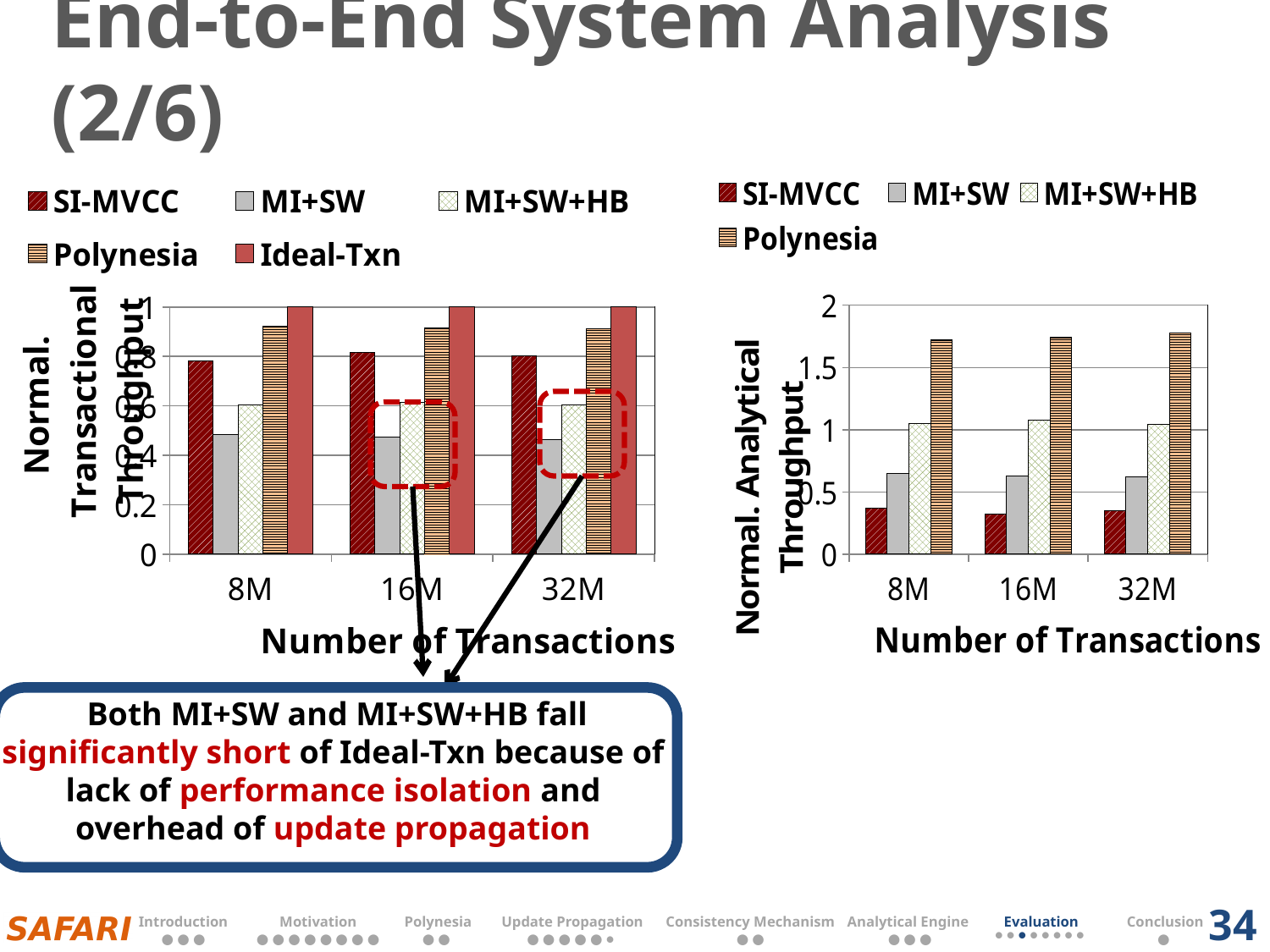
In the left chart (Normal. Transactional Throughput), is the value for MI+SW at 8M greater or less than 0.6? less In the right chart (Normal. Analytical Throughput), is the value for SI-MVCC at 16M greater or less than 0.5? less How many categories are shown on the x axis of the right chart (Normal. Analytical Throughput)? 3 In the left chart (Normal. Transactional Throughput), which is larger at 16M: SI-MVCC or MI+SW? SI-MVCC How many series does the legend of the left chart (Normal. Transactional Throughput) list? 5 In the left chart (Normal. Transactional Throughput), what is the value for Ideal-Txn at 8M? 1 In the left chart (Normal. Transactional Throughput), is the value for SI-MVCC at 8M greater or less than 0.6? greater In the left chart (Normal. Transactional Throughput), which series has the highest bar at 8M? Ideal-Txn In the right chart (Normal. Analytical Throughput), which is larger at 32M: MI+SW or MI+SW+HB? MI+SW+HB In the right chart (Normal. Analytical Throughput), which series has the highest bar at 16M? Polynesia In the right chart (Normal. Analytical Throughput), which series has the lowest bar at 8M? SI-MVCC